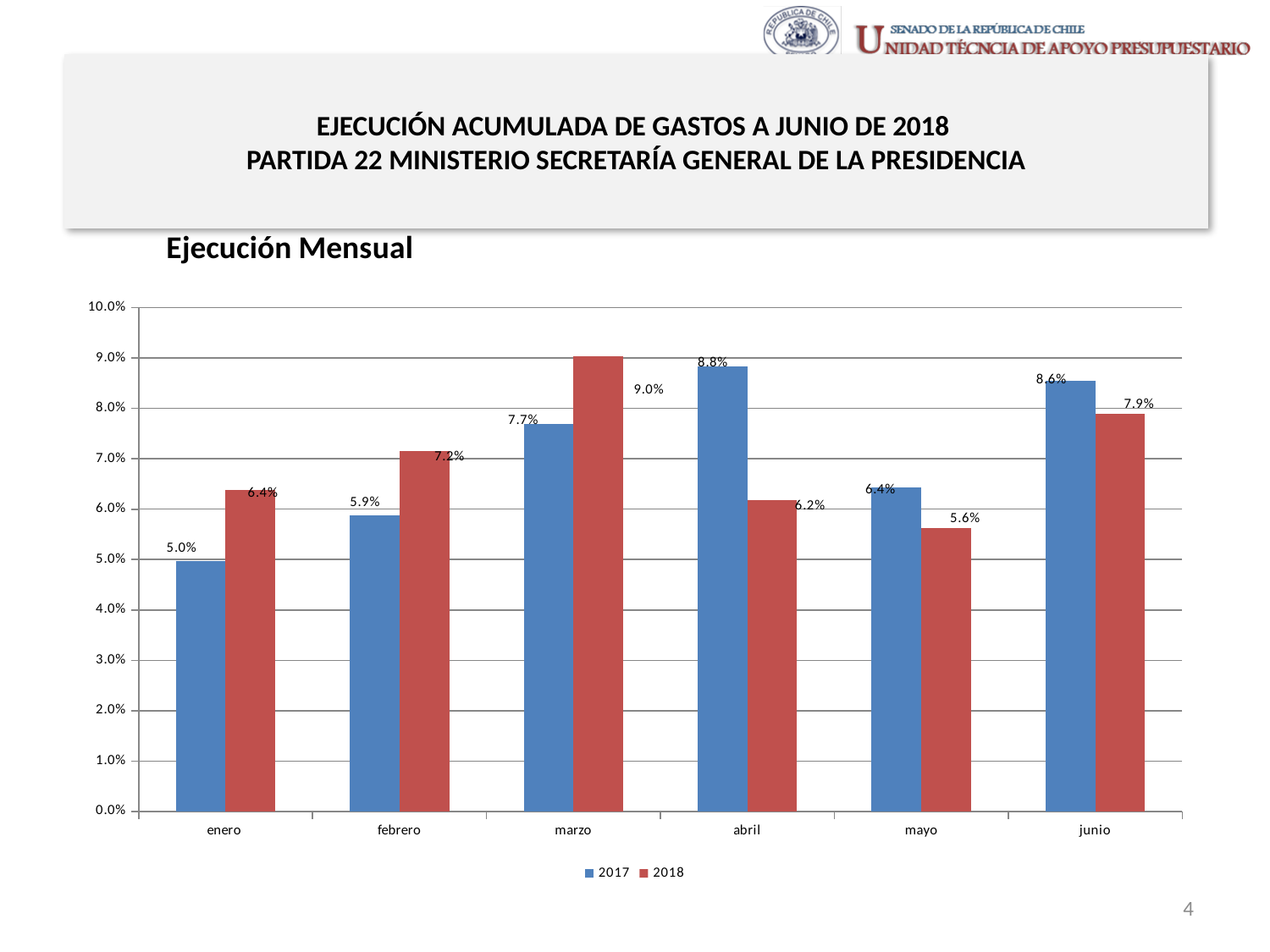
What is the value for 2018 in mayo? 5.6% How many series does the legend list? 2 What is the value for 2017 in enero? 5.0% How many months are shown on the x axis? 6 What is the value for 2018 in marzo? 9.0% Which month has the highest value for the 2018 series? marzo What is the difference between the 2017 and 2018 values in abril? 2.6 percentage points Which month has the lowest value for the 2017 series? enero Is the 2018 value for febrero greater or less than 7.0%? greater Which is larger in junio, the 2017 value or the 2018 value? 2017 What is the value for 2017 in abril? 8.8% What kind of chart is shown on the slide? bar chart